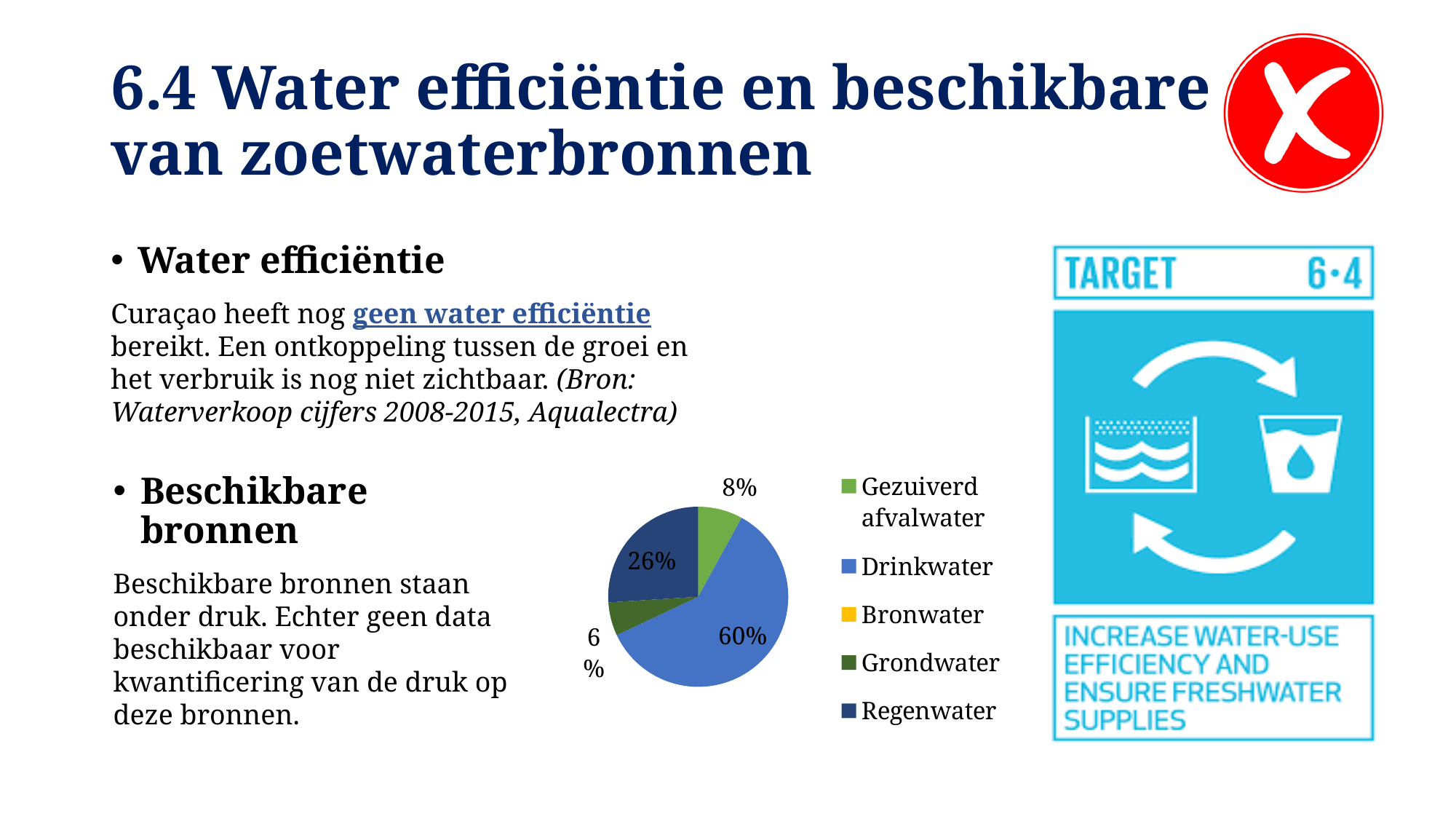
Which legend entry is shown in dark blue? Regenwater What share of the pie does Gezuiverd afvalwater represent? 8% Which is larger, the slice for Regenwater or the slice for Gezuiverd afvalwater? Regenwater Which category has the largest slice of the pie? Drinkwater What is the difference in percentage points between the Gezuiverd afvalwater slice and the Grondwater slice? 2 What is the difference in percentage points between the Drinkwater slice and the Regenwater slice? 34 How many categories does the legend of the pie chart list? 5 What share of the pie does Grondwater represent? 6% What kind of chart is shown on the slide? pie chart What share of the pie does Drinkwater represent? 60% Which legend entry is shown in yellow? Bronwater What share of the pie does Regenwater represent? 26%